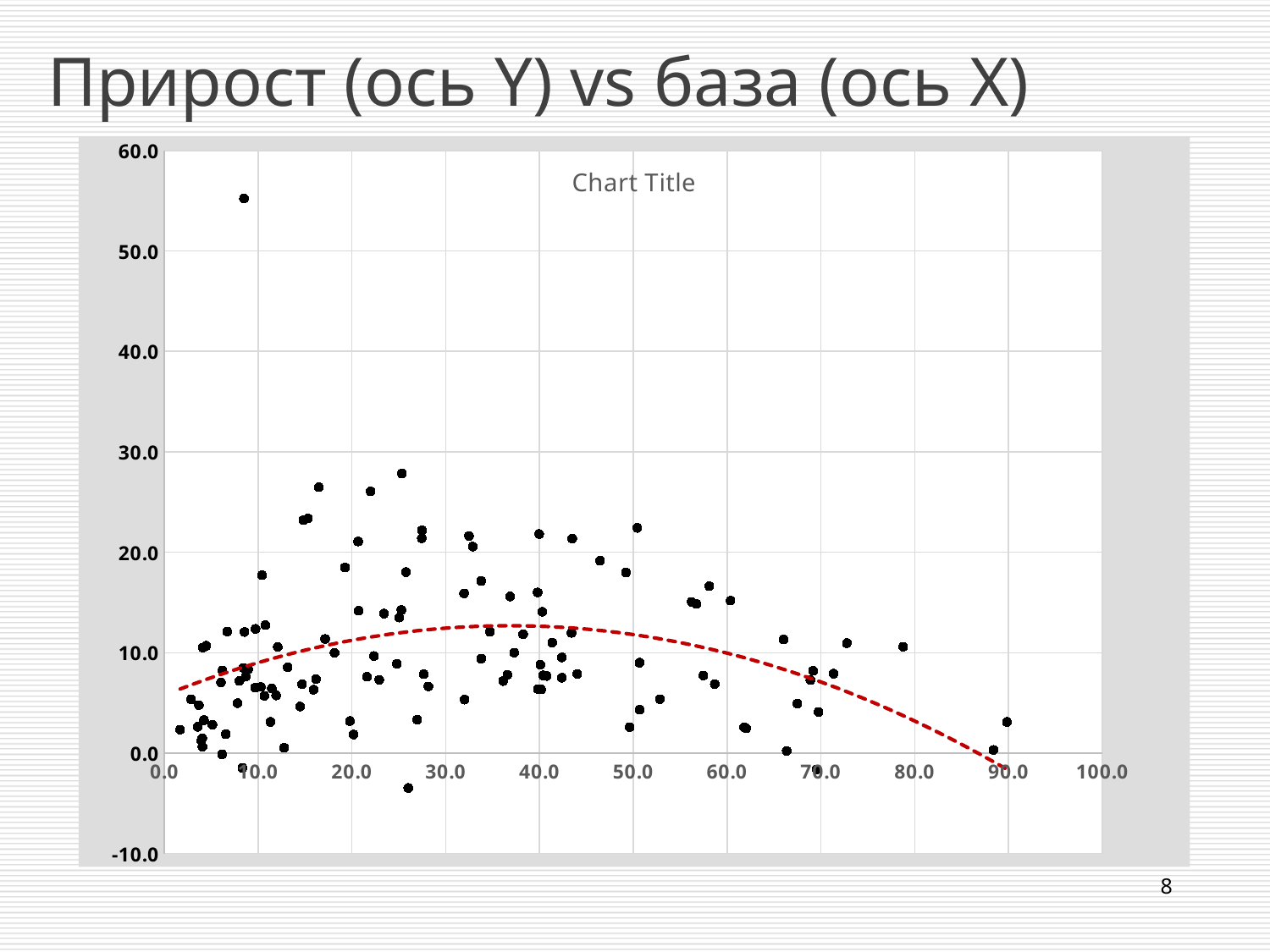
Is the y value of the point near x = 90 greater or less than 10? less Does the dashed trendline rise or fall as x increases from 50 to 90? fall Is the y value of the highest point in the scatter greater or less than 50? greater Does the dashed trendline rise or fall as x increases from 0 to 30? rise What kind of chart is shown on the slide? scatter chart What is the title printed inside the chart area? Chart Title What is the highest value shown on the y axis? 60.0 What is the highest value shown on the x axis? 100.0 Are the points in the scatter mostly above or below the y value of 30? below What is the lowest value shown on the y axis? -10.0